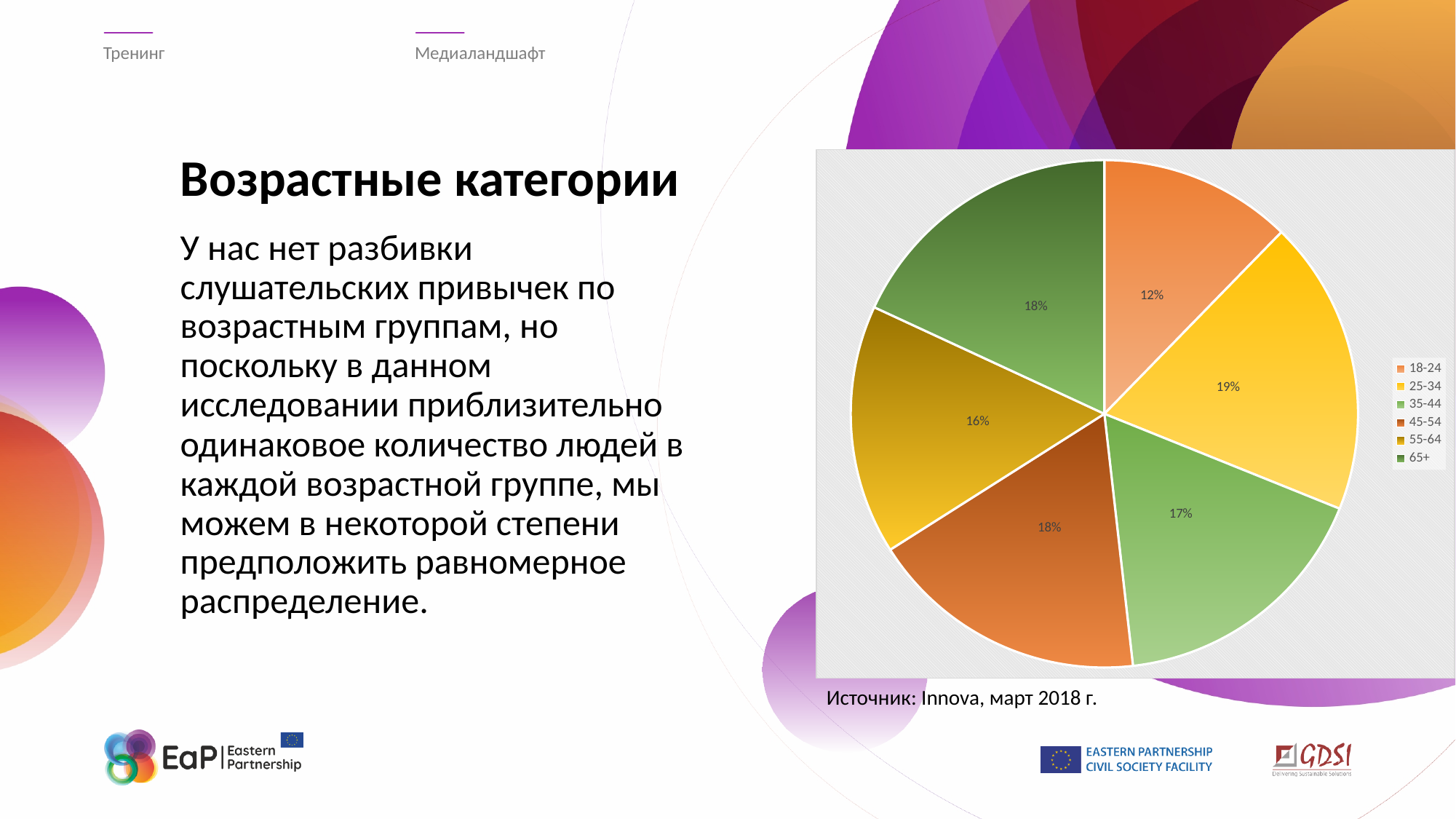
What is the difference in percentage points between the 25-34 and 18-24 age groups? 7 How many age groups are shown in the pie chart? 6 What share of the pie does the 55-64 age group have? 16% What share of the pie does the 25-34 age group have? 19% What kind of chart is shown on the slide? pie chart Which has a larger share, the 35-44 age group or the 55-64 age group? 35-44 What share of the pie does the 35-44 age group have? 17% Which age group has the largest share of the pie? 25-34 What share of the pie does the 65+ age group have? 18% What colour is the slice for the 45-54 age group? brown What share of the pie does the 18-24 age group have? 12% Which age group has the smallest share of the pie? 18-24